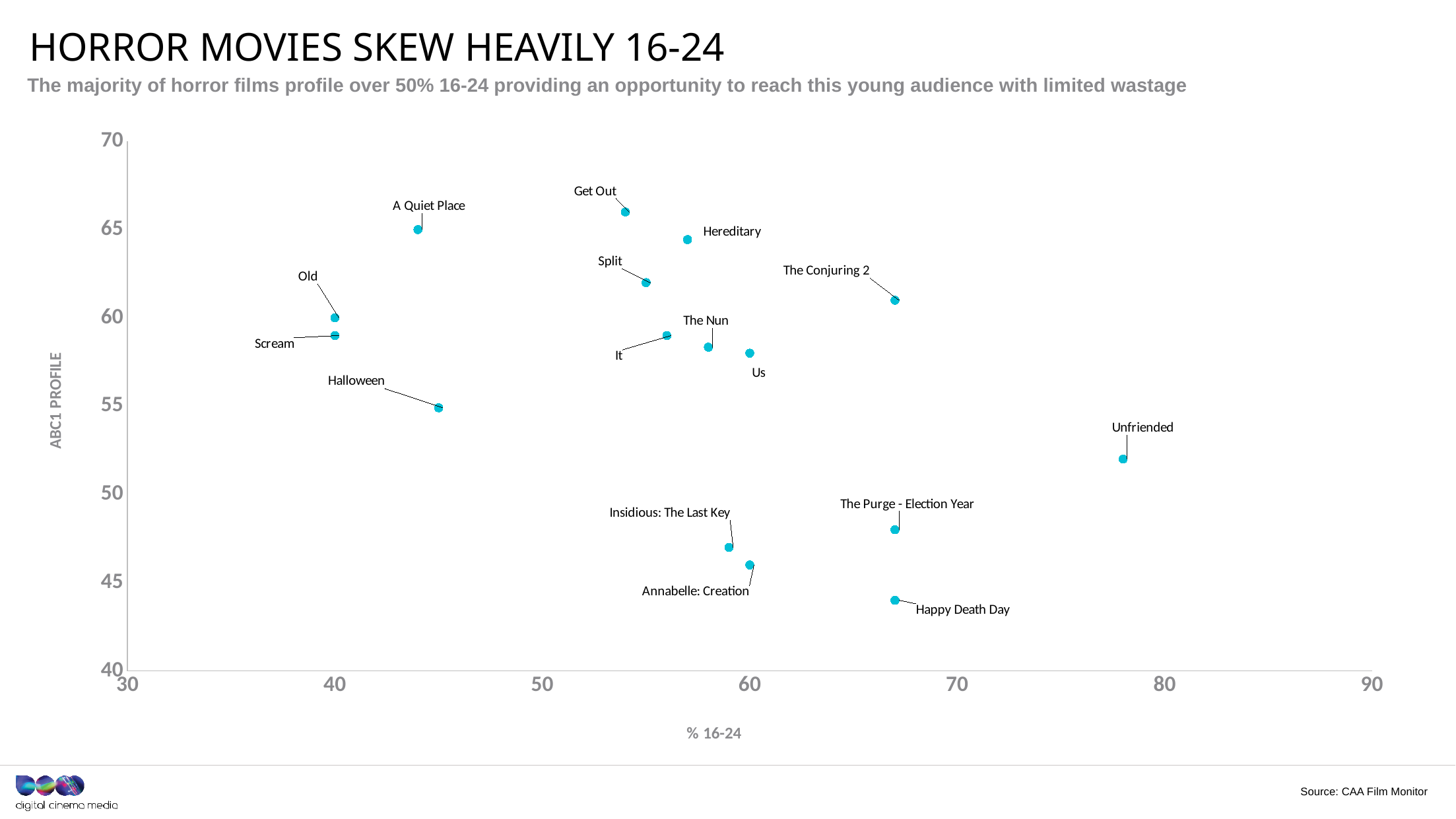
Which film has the highest % 16-24 value? Unfriended Is the ABC1 profile value for Halloween greater or less than 60? less What kind of chart is shown on the slide? Scatter chart What is the label of the horizontal axis of the chart? % 16-24 Is the ABC1 profile value for Happy Death Day greater or less than 45? less Which film has a higher % 16-24 value, Insidious: The Last Key or The Purge - Election Year? The Purge - Election Year Which film has a higher ABC1 profile value, Get Out or Happy Death Day? Get Out Is the % 16-24 value for A Quiet Place greater or less than 50? less How many films are plotted on the chart? 16 Which film has the highest ABC1 profile value? Get Out Which film has the lowest ABC1 profile value? Happy Death Day